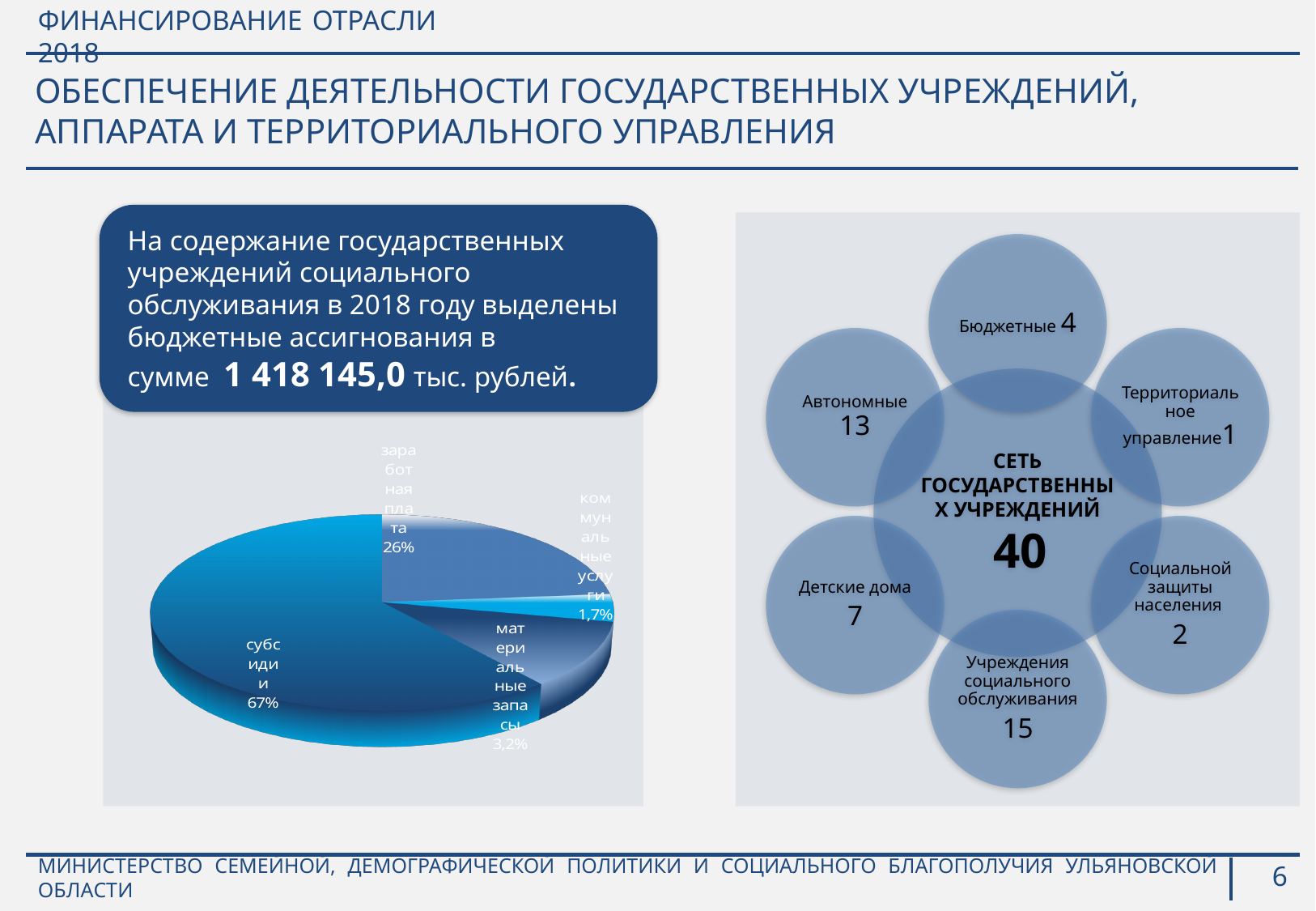
In the pie chart, what share is shown for субсидии? 67% In the pie chart, what share is shown for коммунальные услуги? 1,7% In the pie chart, how many percentage points larger is материальные запасы than коммунальные услуги? 1,5% Which slice of the pie chart is the largest? субсидии In the pie chart, which is larger: материальные запасы or коммунальные услуги? материальные запасы Which slice of the pie chart is the smallest? коммунальные услуги In the pie chart, what share is shown for заработная плата? 26% In the pie chart, what share is shown for материальные запасы? 3,2% What kind of chart is shown on the left side of the slide? pie chart In the pie chart, how many percentage points larger is субсидии than заработная плата? 41% How many slices does the pie chart have? 4